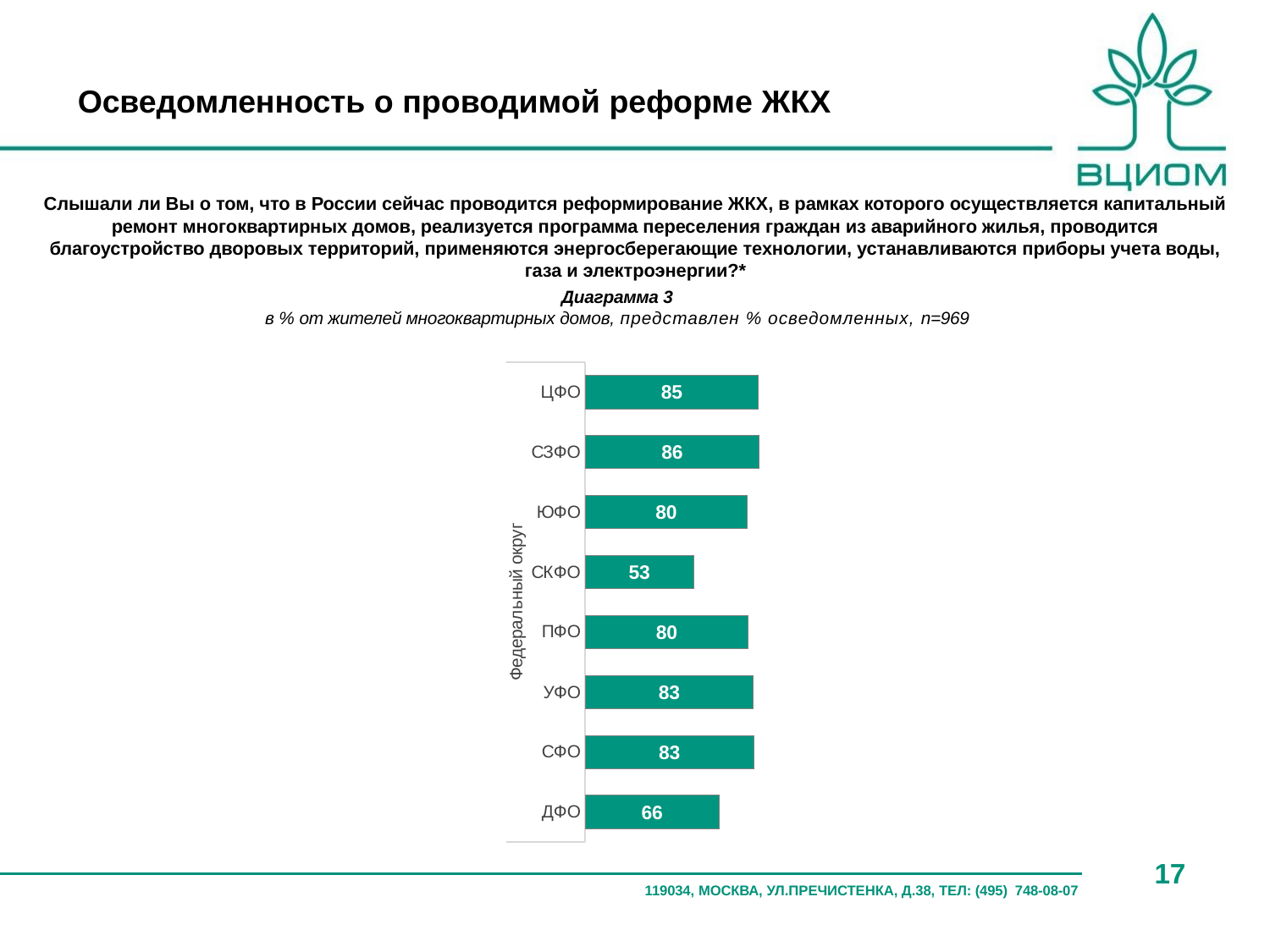
Which is larger, the value for ЮФО or the value for ДФО? ЮФО What is the value for УФО? 83 What is the label of the category axis of the chart? Федеральный округ Which federal district has the lowest value? СКФО How many federal districts are shown in the chart? 8 Which federal district has the highest value? СЗФО What is the value for СКФО? 53 What is the value for ЦФО? 85 What is the value for ДФО? 66 What is the difference between the values for ЦФО and ДФО? 19 What is the difference between the values for СЗФО and СКФО? 33 What kind of chart is shown on the slide? Bar chart